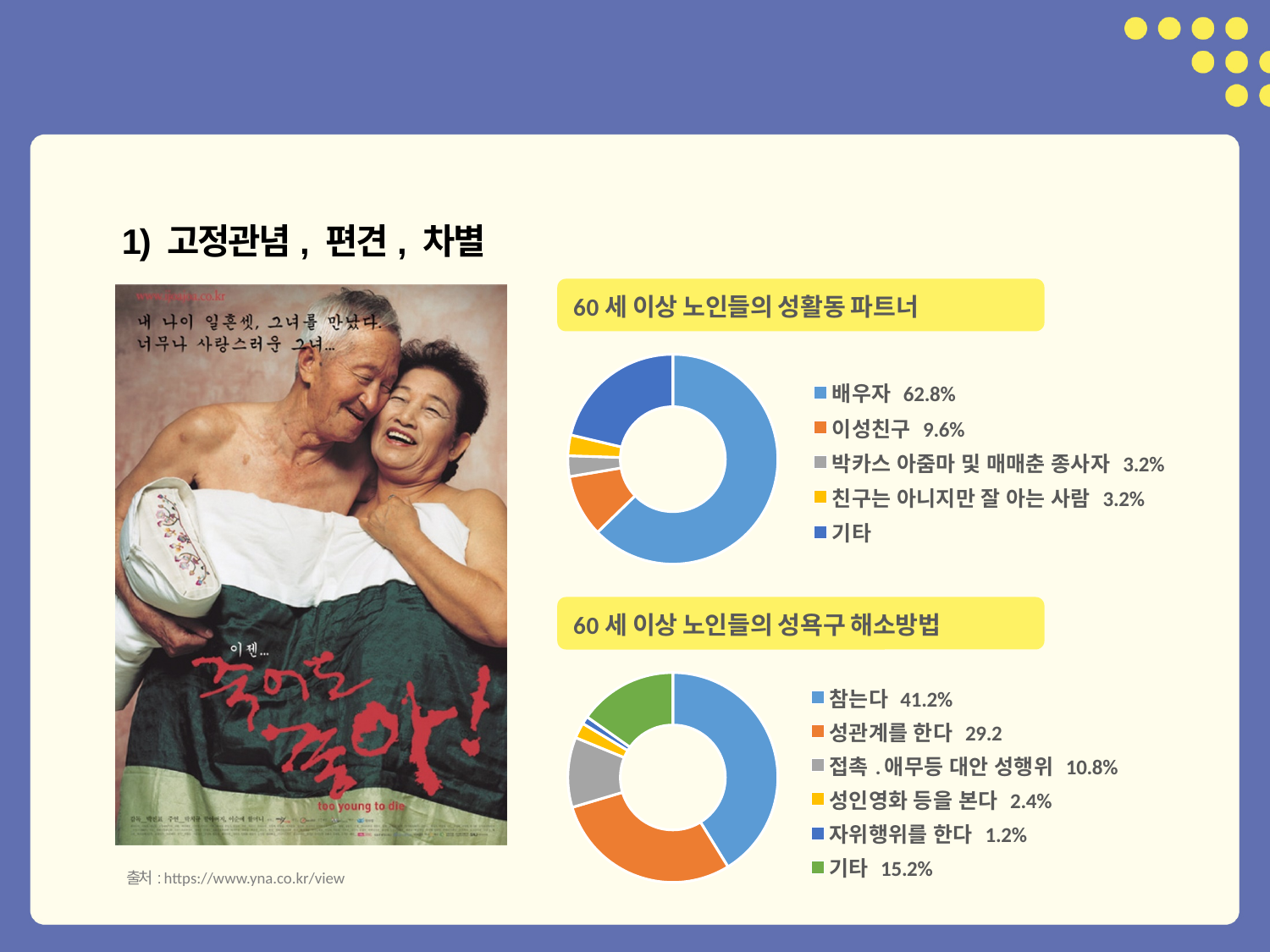
In the chart titled '60 세 이상 노인들의 성활동 파트너', what is the value for 배우자? 62.8% In the chart titled '60 세 이상 노인들의 성활동 파트너', what is the value for 이성친구? 9.6% In the chart titled '60 세 이상 노인들의 성욕구 해소방법', what is the difference between 참는다 and 성관계를 한다? 12 In the chart titled '60 세 이상 노인들의 성욕구 해소방법', what is the value for 자위행위를 한다? 1.2% In the chart titled '60 세 이상 노인들의 성욕구 해소방법', how many categories does the legend list? 6 In the chart titled '60 세 이상 노인들의 성욕구 해소방법', which category has the smallest share? 자위행위를 한다 In the chart titled '60 세 이상 노인들의 성욕구 해소방법', what is the value for 기타? 15.2% In the chart titled '60 세 이상 노인들의 성활동 파트너', which category has the largest share? 배우자 In the chart titled '60 세 이상 노인들의 성욕구 해소방법', what is the value for 참는다? 41.2% In the chart titled '60 세 이상 노인들의 성욕구 해소방법', which is larger: 접촉 . 애무등 대안 성행위 or 기타? 기타 In the chart titled '60 세 이상 노인들의 성활동 파트너', how many categories does the legend list? 5 What kind of chart is the one titled '60 세 이상 노인들의 성활동 파트너'? Donut (pie) chart